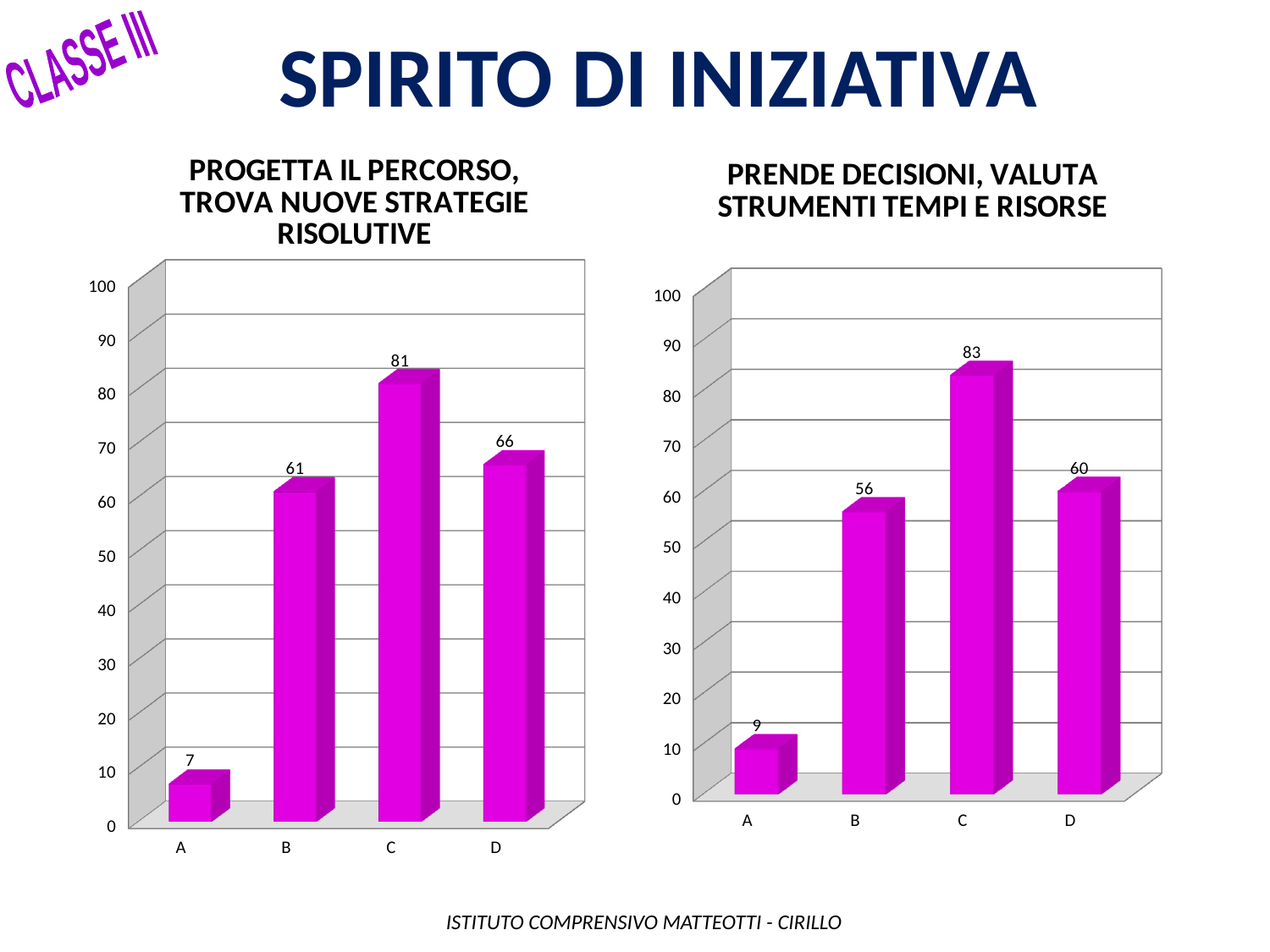
What kind of chart is the left chart (PROGETTA IL PERCORSO, TROVA NUOVE STRATEGIE RISOLUTIVE)? Bar chart In the left chart (PROGETTA IL PERCORSO, TROVA NUOVE STRATEGIE RISOLUTIVE), which category has the lowest value? A In the left chart (PROGETTA IL PERCORSO, TROVA NUOVE STRATEGIE RISOLUTIVE), is the value for D greater or less than 70? less How many categories are shown in the right chart (PRENDE DECISIONI, VALUTA STRUMENTI TEMPI E RISORSE)? 4 In the right chart (PRENDE DECISIONI, VALUTA STRUMENTI TEMPI E RISORSE), what is the difference between the values for D and A? 51 In the right chart (PRENDE DECISIONI, VALUTA STRUMENTI TEMPI E RISORSE), which category has the highest value? C In the left chart (PROGETTA IL PERCORSO, TROVA NUOVE STRATEGIE RISOLUTIVE), what is the difference between the values for C and B? 20 In the right chart (PRENDE DECISIONI, VALUTA STRUMENTI TEMPI E RISORSE), which is larger, the value for B or the value for D? D What is the main title of the slide above the two charts? SPIRITO DI INIZIATIVA In the left chart (PROGETTA IL PERCORSO, TROVA NUOVE STRATEGIE RISOLUTIVE), what is the value for category A? 7 In the right chart (PRENDE DECISIONI, VALUTA STRUMENTI TEMPI E RISORSE), what is the value for category B? 56 In the left chart (PROGETTA IL PERCORSO, TROVA NUOVE STRATEGIE RISOLUTIVE), what is the value for category C? 81